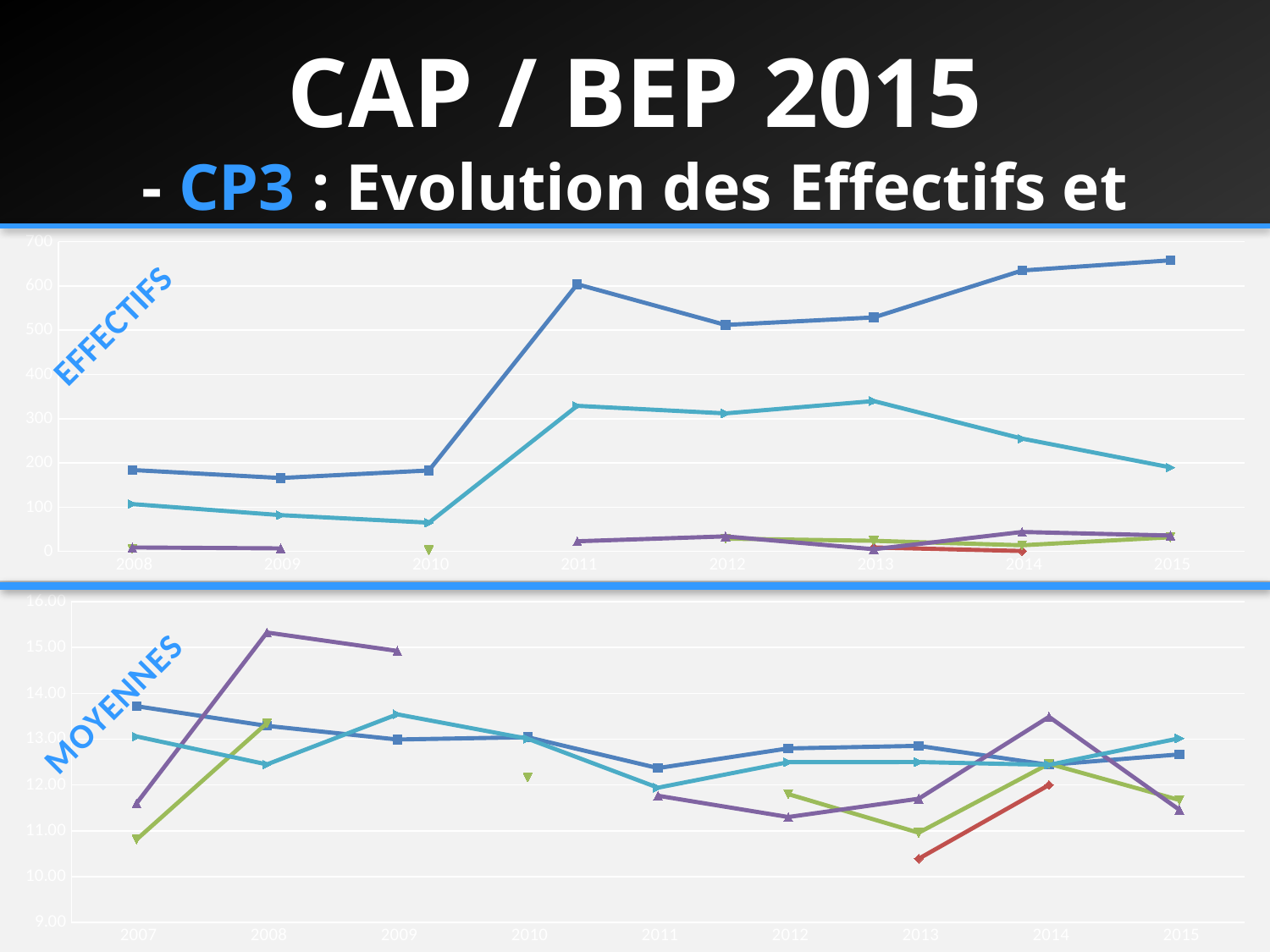
In the top chart (EFFECTIFS), in which year is the teal line at its lowest? 2010 In the bottom chart (MOYENNES), is the value of the red line in 2013 greater or less than 11.00? less How many years are shown on the x axis of the bottom chart (MOYENNES)? 9 In the top chart (EFFECTIFS), in which year is the dark blue line at its lowest? 2009 In the top chart (EFFECTIFS), in which year does the dark blue line reach its highest value? 2015 In the top chart (EFFECTIFS), is the value of the teal line in 2014 greater or less than 200? greater In the top chart (EFFECTIFS), does the dark blue line rise or fall from 2013 to 2015? rise How many years are shown on the x axis of the top chart (EFFECTIFS)? 8 In the top chart (EFFECTIFS), does the teal line rise or fall from 2013 to 2015? fall In the bottom chart (MOYENNES), in which year does the purple line reach its highest value? 2008 What kind of chart is the top chart labelled EFFECTIFS? line chart In the top chart (EFFECTIFS), is the value of the dark blue line in 2011 greater or less than 500? greater